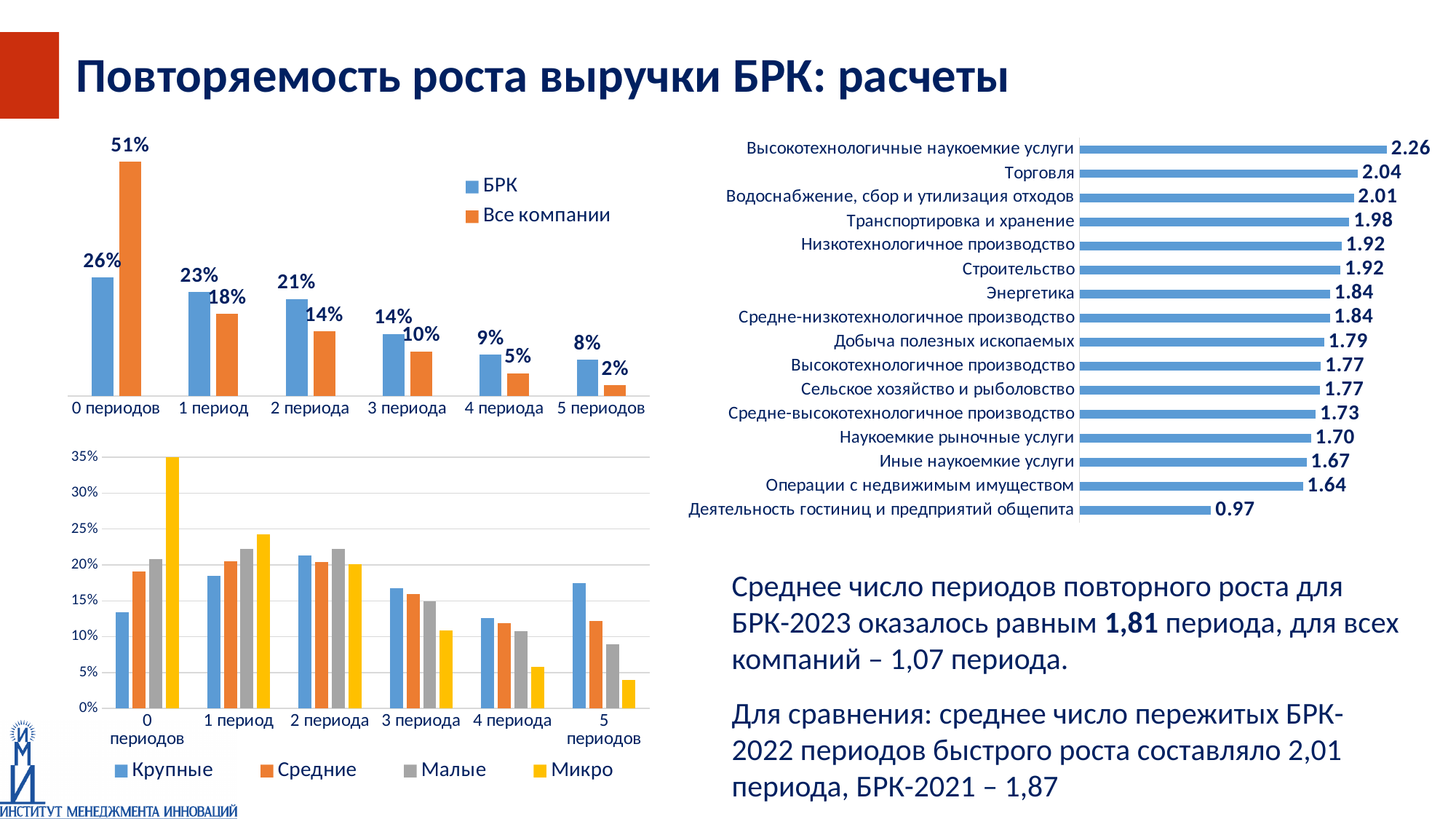
In the bottom-left chart, how many series does the legend list? 4 In the top-left chart, what is the difference between Все компании and БРК at 0 периодов? 25% In the right chart, which category has the lowest value? Деятельность гостиниц и предприятий общепита In the right chart, what is the value for Торговля? 2.04 In the top-left chart, which series has the larger value at 2 периода, БРК or Все компании? БРК In the top-left chart, what is the value for Все компании at 5 периодов? 2% In the right chart, which category has the highest value? Высокотехнологичные наукоемкие услуги In the top-left chart, how many series does the legend list? 2 In the top-left chart, what is the value for Все компании at 0 периодов? 51% In the right chart, how many categories are shown? 16 In the top-left chart, what is the value for БРК at 0 периодов? 26% In the bottom-left chart, is the value for Микро at 0 периодов greater or less than 30%? greater